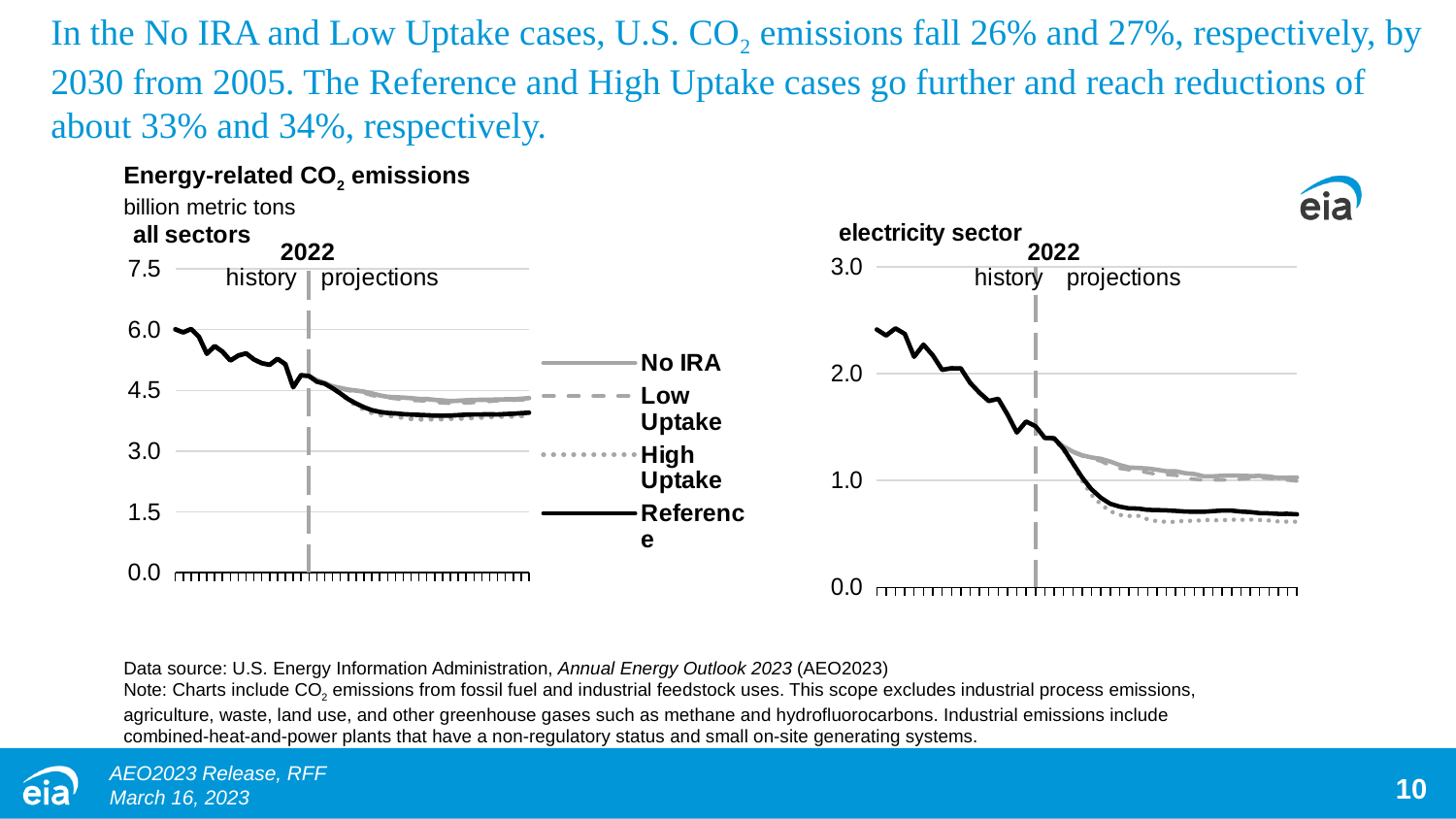
What type of chart is the "all sectors" chart? line chart What type of chart is the "electricity sector" chart? line chart In the "all sectors" chart, is the Reference value at the end of the projection period greater or less than 4.5? less In the "all sectors" chart, do the emissions values generally rise or fall from left to right along the x axis? fall In the "electricity sector" chart, do the emissions values generally rise or fall from left to right along the x axis? fall What are the names of the series listed in the legend? No IRA, Low Uptake, High Uptake, Reference In the "all sectors" chart, which series is higher at the end of the projection period, No IRA or High Uptake? No IRA What unit is shown for the Energy-related CO2 emissions charts? billion metric tons In the "electricity sector" chart, is the Reference value at the end of the projection period greater or less than 1.0? less In the "electricity sector" chart, which series is higher at the end of the projection period, No IRA or Reference? No IRA How many series does the legend list for the charts? 4 In the "electricity sector" chart, is the value at the start of the history period greater or less than 2.0? greater